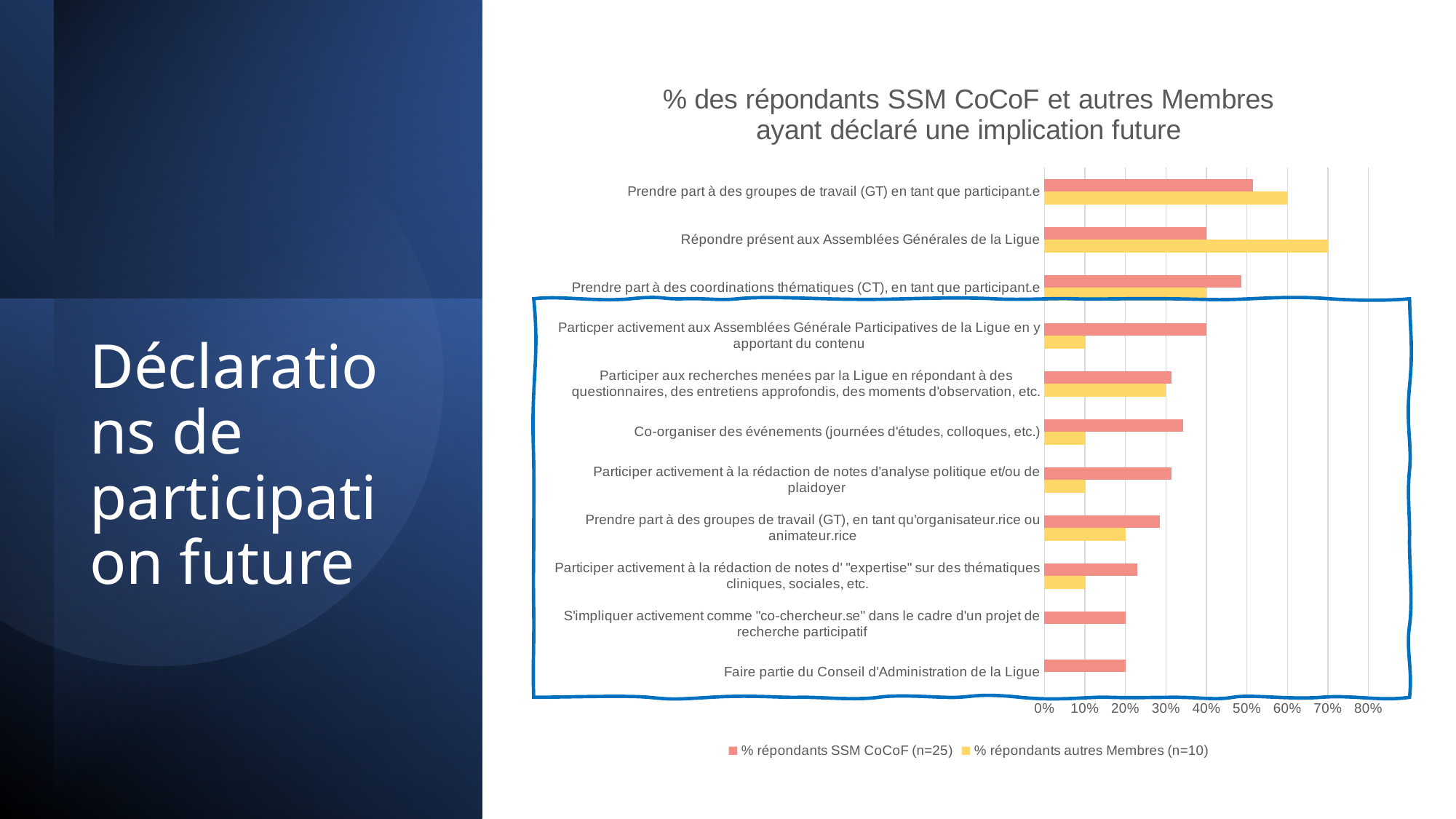
Which category has the highest value for '% répondants autres Membres (n=10)'? Répondre présent aux Assemblées Générales de la Ligue Is the value for '% répondants SSM CoCoF (n=25)' for 'Faire partie du Conseil d'Administration de la Ligue' greater or less than 30%? less For 'Répondre présent aux Assemblées Générales de la Ligue', which series has the larger value? % répondants autres Membres (n=10) What is the title of the chart? % des répondants SSM CoCoF et autres Membres ayant déclaré une implication future For 'Co-organiser des événements (journées d'études, colloques, etc.)', which series has the larger value? % répondants SSM CoCoF (n=25) What is the value for '% répondants autres Membres (n=10)' for 'Prendre part à des groupes de travail (GT) en tant que participant.e'? 60% How many series does the legend list? 2 How many categories are plotted on the chart? 11 What kind of chart is shown on the slide? bar chart Is the value for '% répondants SSM CoCoF (n=25)' for 'Prendre part à des groupes de travail (GT) en tant que participant.e' greater or less than 40%? greater What is the value for '% répondants autres Membres (n=10)' for 'Co-organiser des événements (journées d'études, colloques, etc.)'? 10% What is the value for '% répondants autres Membres (n=10)' for 'Répondre présent aux Assemblées Générales de la Ligue'? 70%